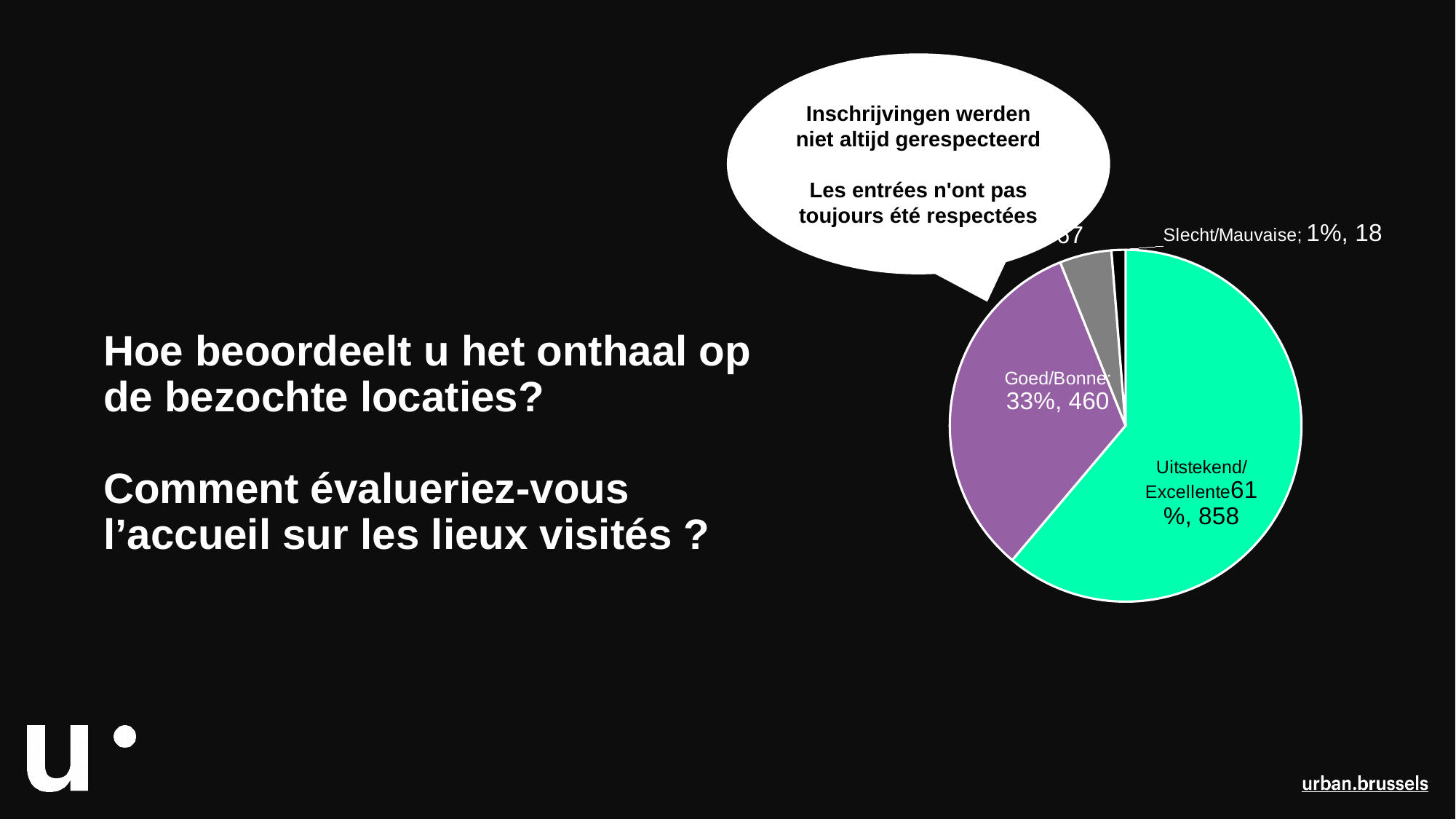
Which is larger, the Goed/Bonne slice or the Slecht/Mauvaise slice? Goed/Bonne What count is shown for the Goed/Bonne slice? 460 Which category has the largest slice of the pie? Uitstekend/Excellente Which category has the smallest slice of the pie? Slecht/Mauvaise What percentage share does the Slecht/Mauvaise slice have? 1% How many slices does the pie chart have? 4 What percentage share does the Uitstekend/Excellente slice have? 61% What kind of chart is shown on the slide? pie chart What count is shown for the Slecht/Mauvaise slice? 18 What percentage share does the Goed/Bonne slice have? 33% What is the difference in count between Uitstekend/Excellente and Goed/Bonne? 398 What count is shown for the Uitstekend/Excellente slice? 858